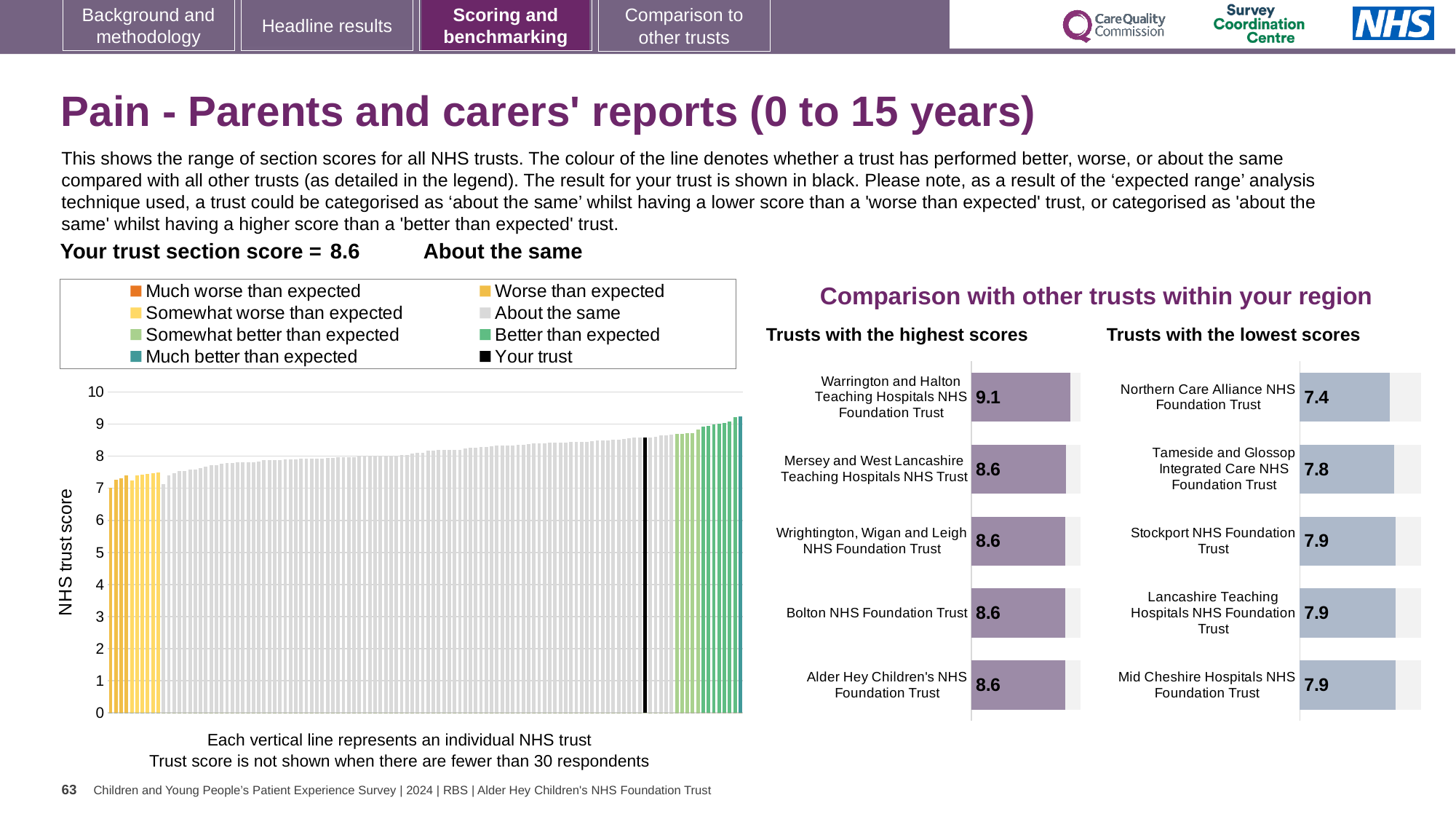
In the 'Trusts with the lowest scores' chart, which trust has the lowest score? Northern Care Alliance NHS Foundation Trust In the 'Trusts with the lowest scores' chart, which has the larger score: Stockport NHS Foundation Trust or Northern Care Alliance NHS Foundation Trust? Stockport NHS Foundation Trust In the 'Trusts with the highest scores' chart, what is the difference between the score for Warrington and Halton Teaching Hospitals NHS Foundation Trust and the score for Bolton NHS Foundation Trust? 0.5 How many trusts are listed in the 'Trusts with the lowest scores' chart? 5 In the large chart on the left showing all NHS trusts, do the bar values rise or fall from left to right? rise What kind of chart is the large chart on the left showing all NHS trusts? bar chart In the 'Trusts with the highest scores' chart, what is the score for Warrington and Halton Teaching Hospitals NHS Foundation Trust? 9.1 How many entries does the legend above the large chart on the left list? 8 In the 'Trusts with the lowest scores' chart, what is the score for Tameside and Glossop Integrated Care NHS Foundation Trust? 7.8 In the 'Trusts with the lowest scores' chart, what is the score for Northern Care Alliance NHS Foundation Trust? 7.4 In the 'Trusts with the highest scores' chart, which trust has the highest score? Warrington and Halton Teaching Hospitals NHS Foundation Trust In the large chart on the left showing all NHS trusts, is the value for the black bar (your trust) greater or less than 8? greater